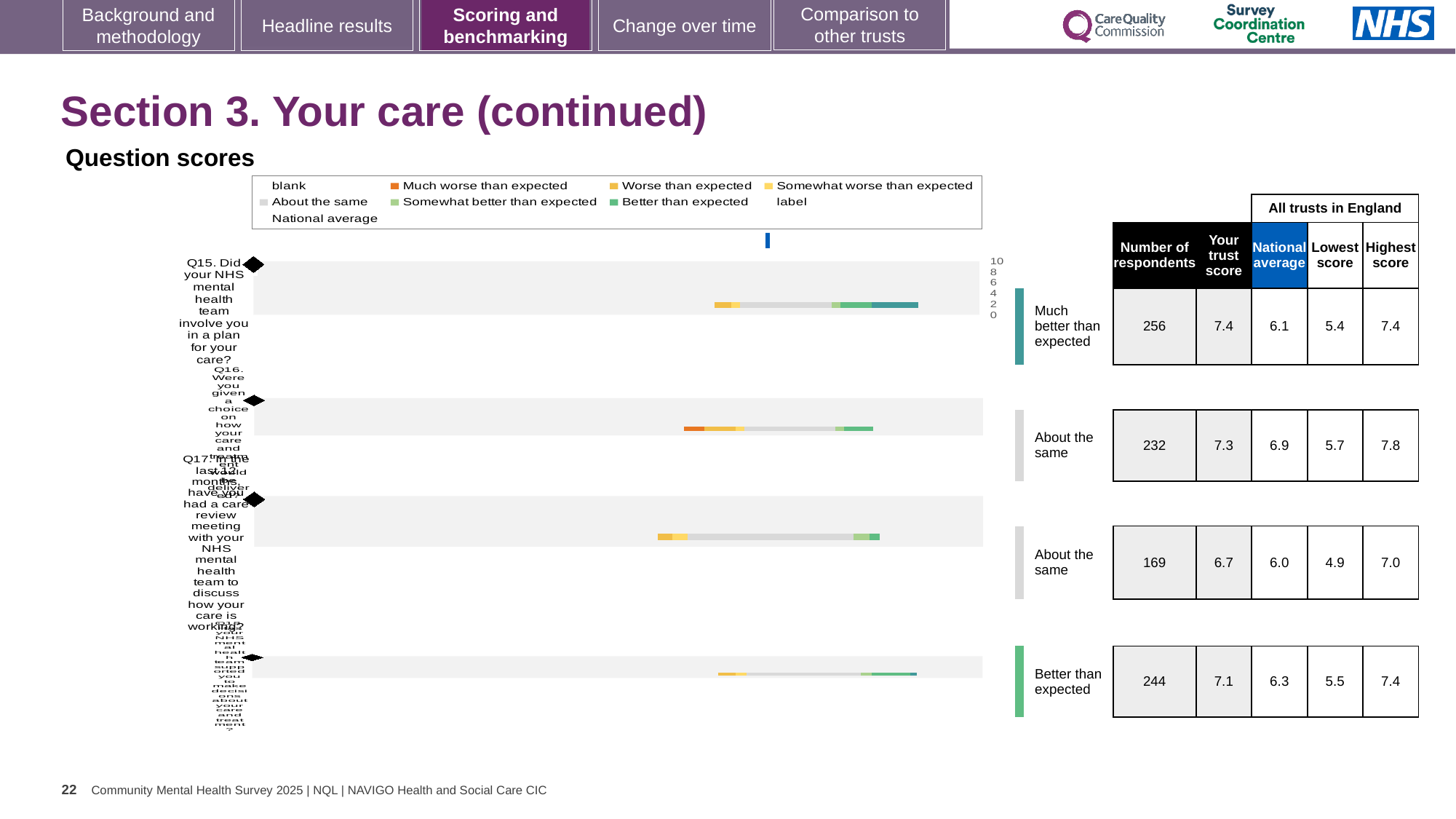
What is the trust score for Q15 (Did your NHS mental health team involve you in a plan for your care?)? 7.4 What is the national average for Q17 (care review meeting in the last 12 months)? 6.0 What is the difference between the trust score and the national average for Q15? 1.3 Which question has the lowest trust score? Q17 Which question has the highest trust score? Q15 What kind of chart is used to show the question scores on this slide? bar chart What benchmark category is shown for Q15? Much better than expected How many questions (rows) are plotted in the question scores chart? 4 How many respondents answered Q15 (involve you in a plan for your care)? 256 What is the lowest score among all trusts in England for Q17? 4.9 What benchmark category is shown for the fourth (bottom) question row? Better than expected For Q16 (choice on how your care and treatment would be delivered), which is larger: the trust score or the national average? trust score